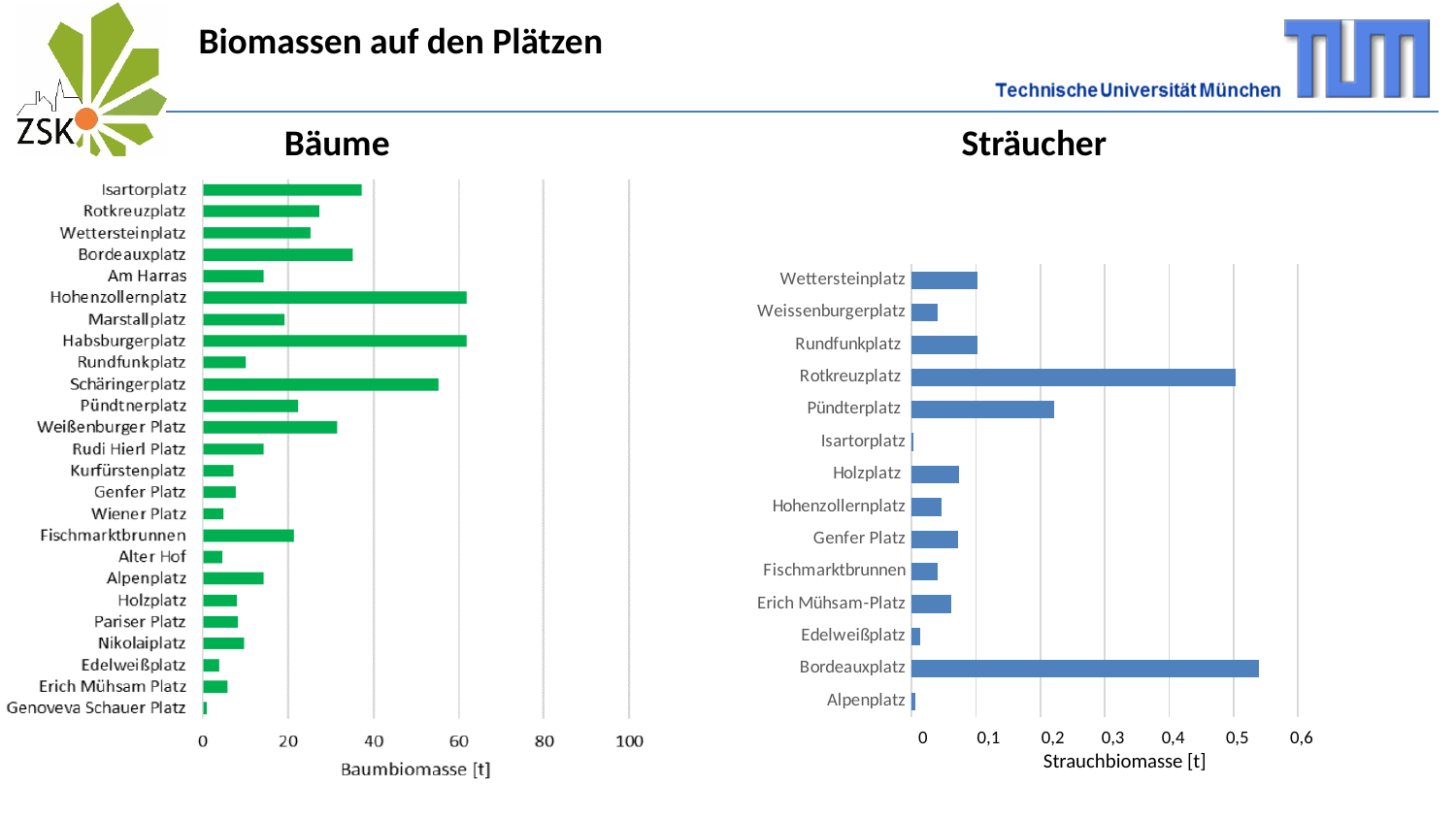
How many places are listed in the Bäume chart? 25 In the Sträucher chart, is the value for Holzplatz greater or less than 0,1? less In the Bäume chart, is the value for Rundfunkplatz greater or less than 20? less What kind of chart is the Bäume chart? bar chart In the Sträucher chart, which place has the highest shrub biomass? Bordeauxplatz How many places are listed in the Sträucher chart? 14 What is the x-axis label of the Sträucher chart? Strauchbiomasse [t] In the Sträucher chart, is the value for Rotkreuzplatz greater or less than 0,4? greater In the Bäume chart, which has the larger value, Bordeauxplatz or Rotkreuzplatz? Bordeauxplatz In the Bäume chart, which place has the lowest tree biomass? Genoveva Schauer Platz In the Sträucher chart, which has the larger value, Rotkreuzplatz or Pündterplatz? Rotkreuzplatz